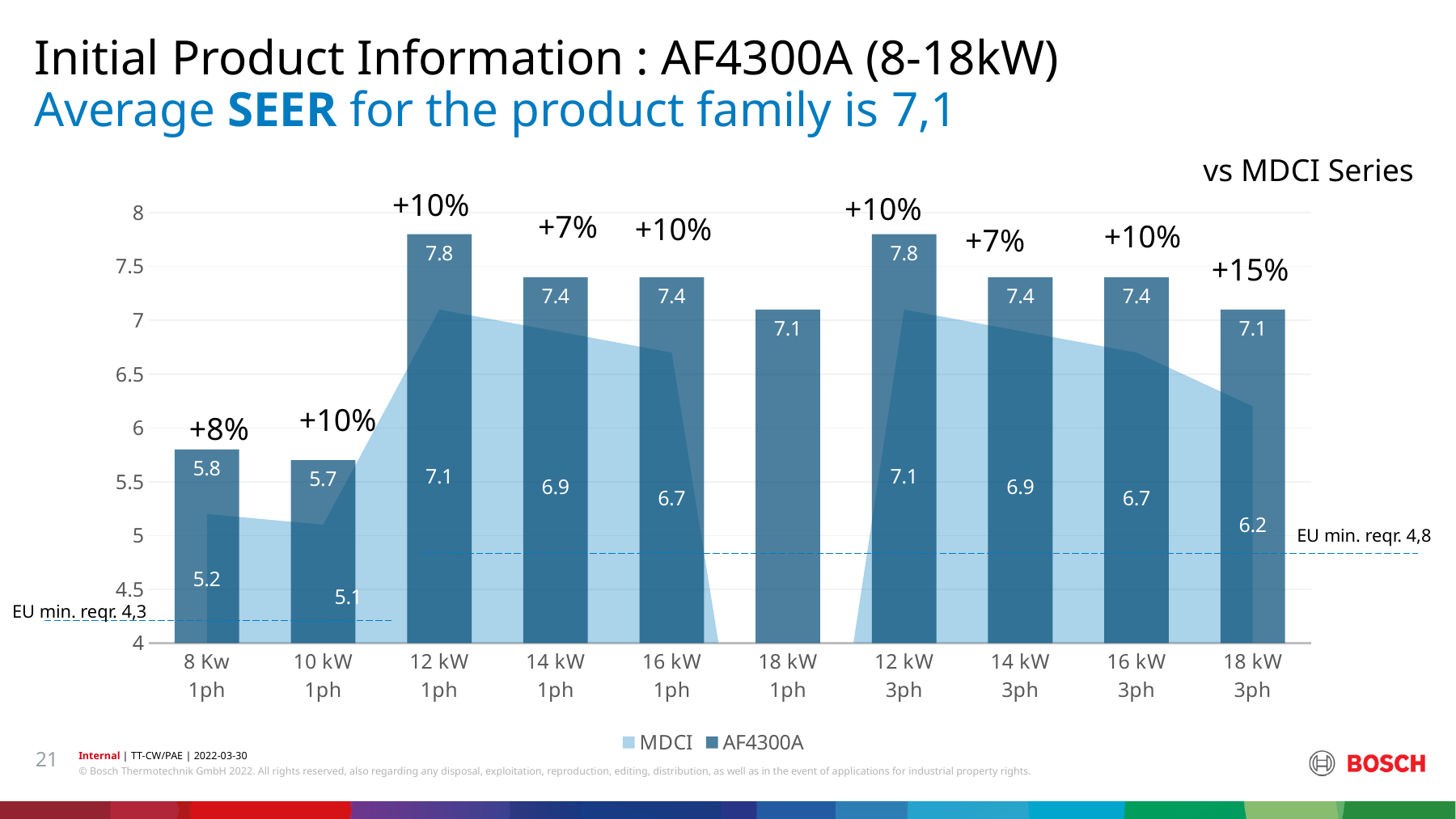
How many categories are shown on the x axis? 10 Is the MDCI value for 10 kW 1ph greater or less than 5.5? less What is the AF4300A value for 12 kW 1ph? 7.8 What is the AF4300A value for 8 Kw 1ph? 5.8 What kind of chart is used for the AF4300A series? bar chart What percentage improvement is labelled above the 18 kW 3ph bar? +15% What is the difference between the AF4300A and MDCI values for 18 kW 3ph? 0.9 What is the MDCI value for 18 kW 3ph? 6.2 What is the MDCI value for 16 kW 3ph? 6.7 Which is larger, the AF4300A value for 14 kW 1ph or the AF4300A value for 18 kW 1ph? 14 kW 1ph Which category has the lowest AF4300A value? 10 kW 1ph How many series does the legend list? 2